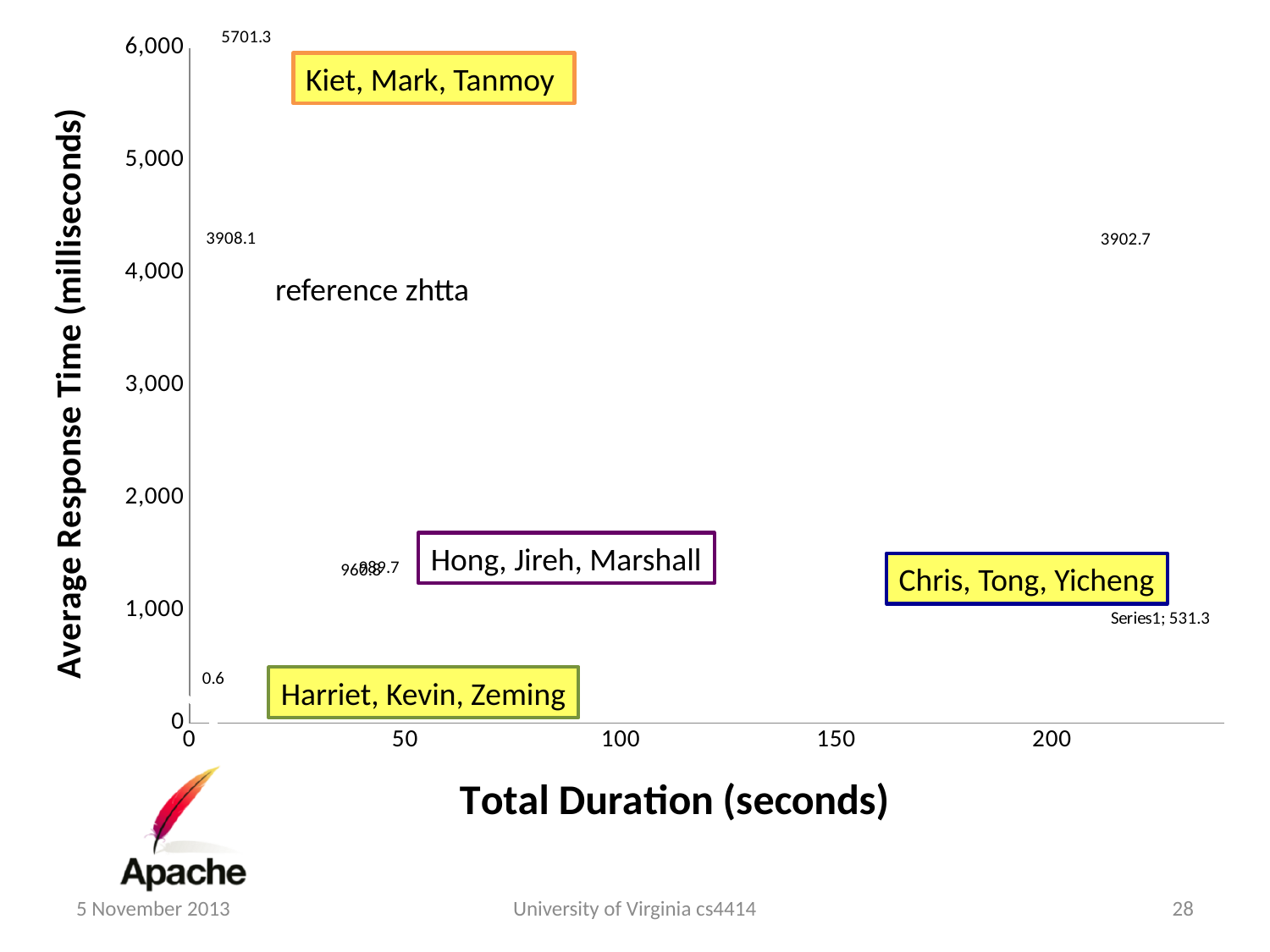
What is the average response time labelled for the point annotated 'Kiet, Mark, Tanmoy'? 5701.3 Is the average response time of the point labelled 'Series1; 531.3' greater or less than 1,000? less What is the average response time labelled for the point annotated 'reference zhtta'? 3908.1 Is the average response time of the point labelled 3902.7 greater or less than 3,000? greater What is the title of the vertical axis? Average Response Time (milliseconds) What is the difference between the labelled values 5701.3 and 3908.1? 1793.2 Which labelled value is larger, 3908.1 or 3902.7? 3908.1 What is the highest average response time value labelled on the chart? 5701.3 What kind of chart is shown on the slide? scatter chart What is the difference between the labelled values 3908.1 and 3902.7? 5.4 What is the title of the horizontal axis? Total Duration (seconds) What is the lowest average response time value labelled on the chart? 0.6